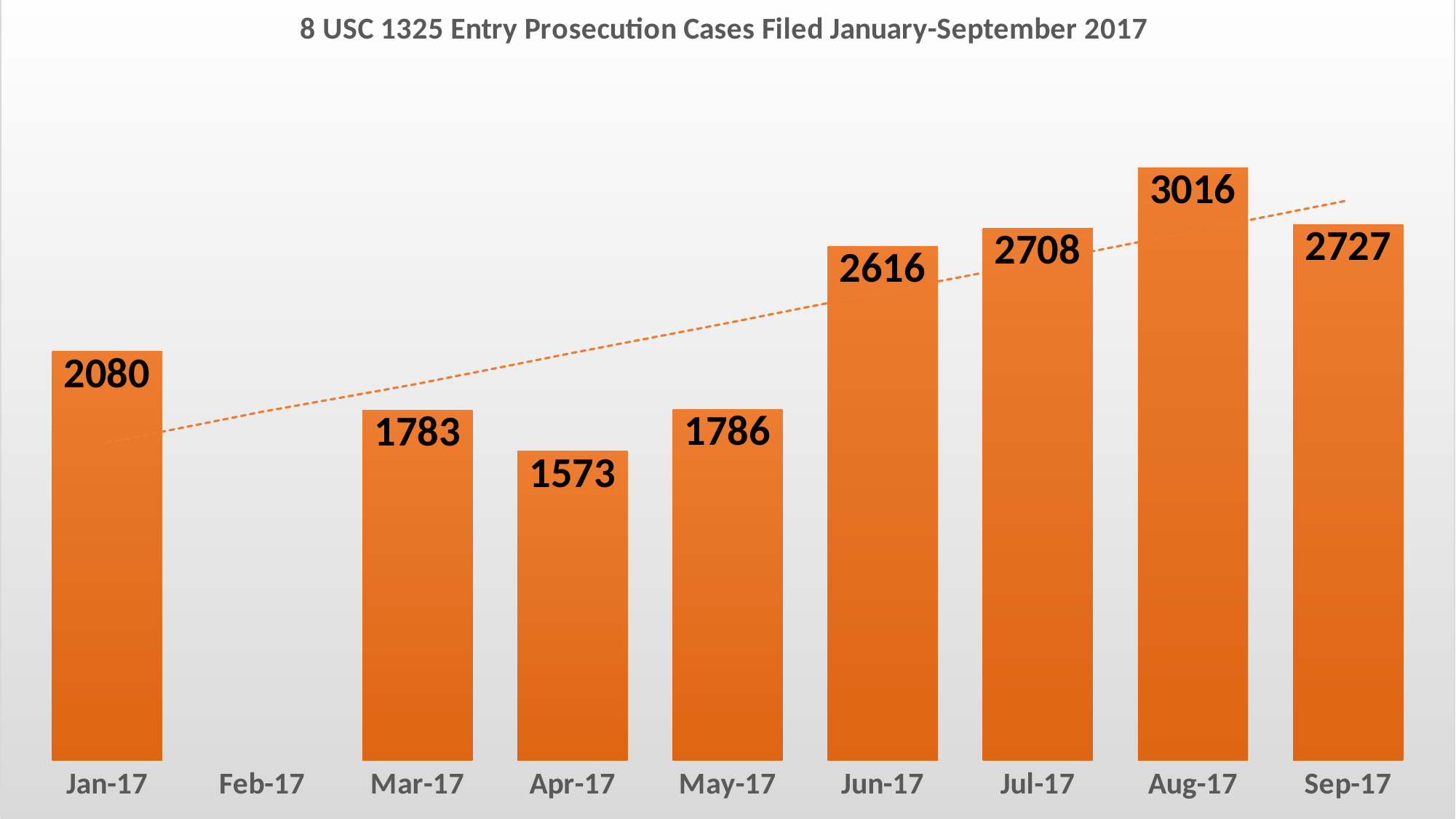
Which is larger, the value for Jul-17 or the value for Sep-17? Sep-17 What type of chart is shown on the slide? Bar chart Which month has the highest number of cases filed? Aug-17 Which month with a bar has the lowest number of cases filed? Apr-17 What is the title of the chart? 8 USC 1325 Entry Prosecution Cases Filed January-September 2017 What is the value shown for Apr-17? 1573 Which month on the x axis has no bar shown? Feb-17 What is the difference between the values for Jan-17 and Apr-17? 507 How many cases were filed in Aug-17? 3016 What is the difference between the values for Aug-17 and Sep-17? 289 What is the value shown for Jun-17? 2616 How many months are labelled on the x axis? 9